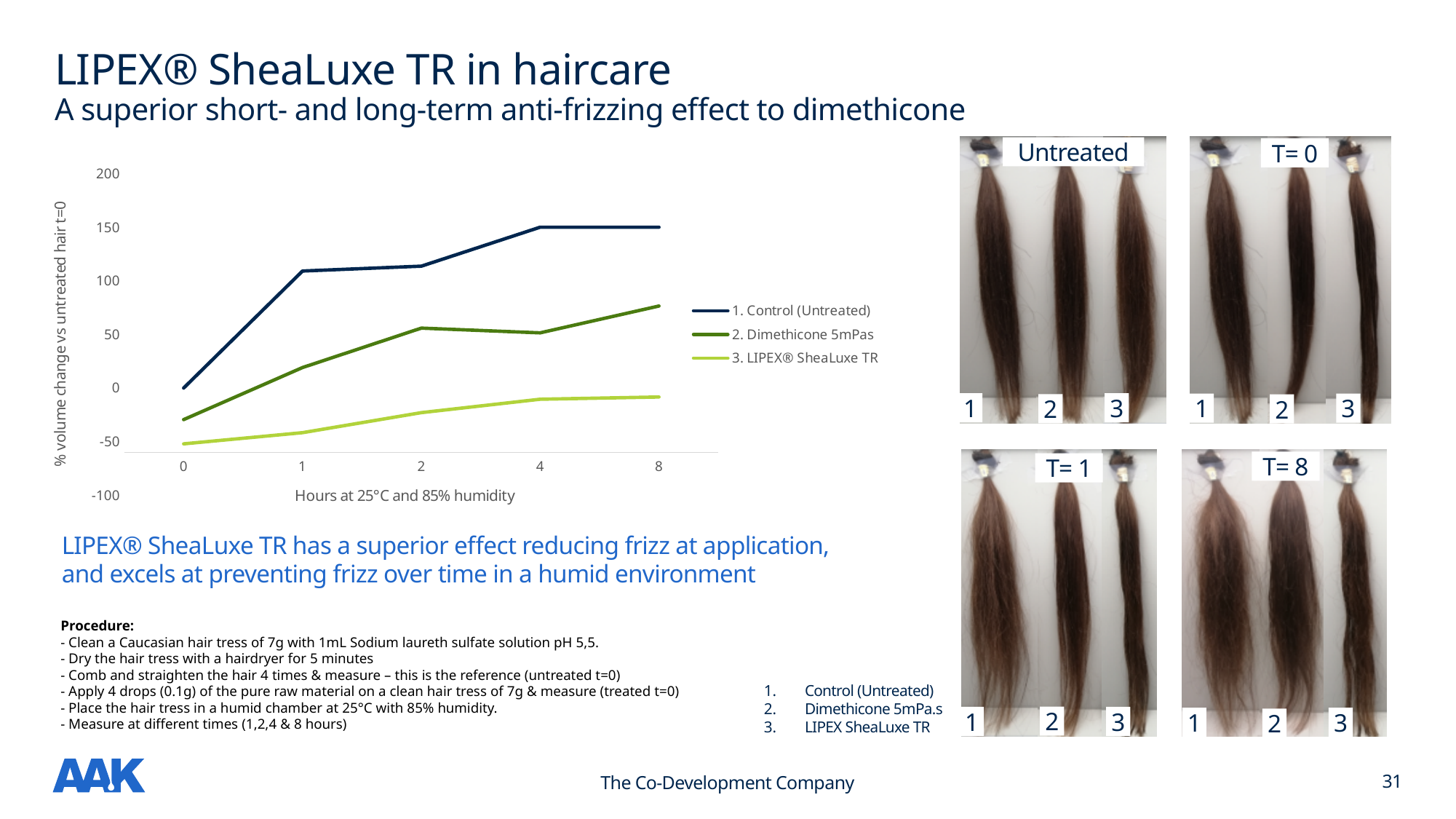
Is the value for 2. Dimethicone 5mPas at 8 hours greater or less than 50? greater What is the title of the x axis of the chart? Hours at 25°C and 85% humidity At 8 hours, which is larger: the value for 1. Control (Untreated) or the value for 3. LIPEX® SheaLuxe TR? 1. Control (Untreated) What kind of chart is shown on the slide? Line chart Does the value for 1. Control (Untreated) rise or fall from 0 to 8 hours? Rise How many time points are plotted along the x axis of the chart? 5 Which series has the lowest value at 8 hours? 3. LIPEX® SheaLuxe TR Which series has the highest value at 8 hours? 1. Control (Untreated) Is the value for 3. LIPEX® SheaLuxe TR at 0 hours greater or less than 0? less Is the value for 1. Control (Untreated) at 8 hours greater or less than 100? greater How many series does the chart legend list? 3 What is the value for 1. Control (Untreated) at 0 hours? 0